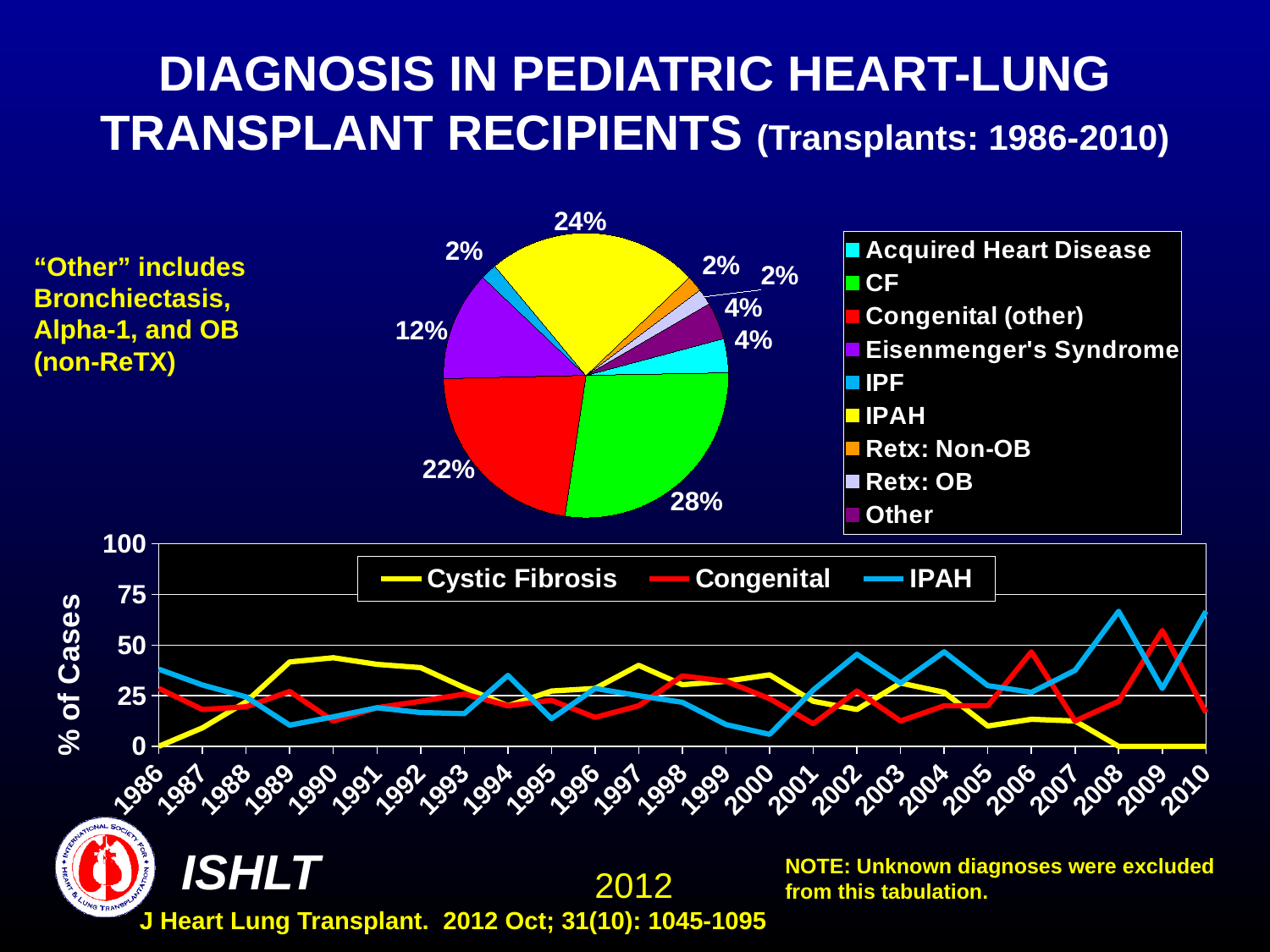
In the pie chart, what percentage is shown for Eisenmenger's Syndrome? 12% In the lower line chart, is the value for IPAH in 2008 greater or less than 50? greater In the pie chart, what percentage is shown for IPAH? 24% What kind of chart is the upper chart on the slide? Pie chart In the pie chart, what share of pediatric heart-lung transplant recipients had CF as their diagnosis? 28% In the pie chart, what is the difference in percentage points between the CF slice and the Congenital (other) slice? 6 In the lower line chart, what is the label on the y axis? % of Cases How many diagnosis categories does the pie chart legend list? 9 In the pie chart, which is larger: the IPAH slice or the Eisenmenger's Syndrome slice? IPAH How many series does the legend of the lower line chart list? 3 In the pie chart, which diagnosis has the largest share? CF In the lower line chart, is the value for Cystic Fibrosis in 2009 greater or less than 25? less